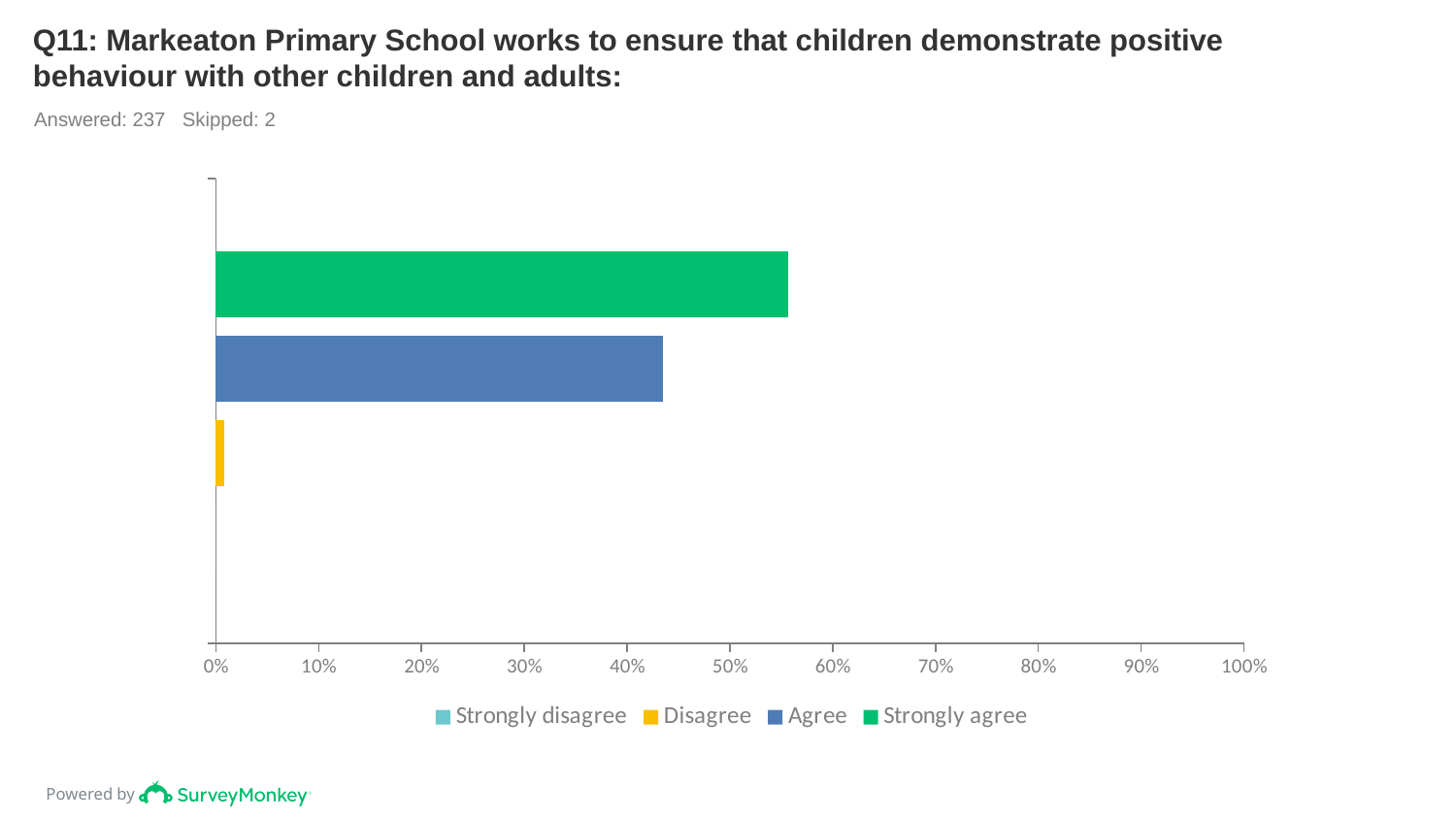
How many series does the legend list? 4 What kind of chart is shown on the slide? Bar chart Which is larger, the value for Strongly agree or the value for Agree? Strongly agree Which response has the longest bar? Strongly agree What colour is the Strongly agree bar? Green Is the value for Agree greater or less than 50%? less Which is larger, the value for Agree or the value for Disagree? Agree Which of the visible bars is the shortest? Disagree How many respondents answered this question according to the slide? 237 Is the value for Agree greater or less than 40%? greater Is the value for Disagree greater or less than 10%? less